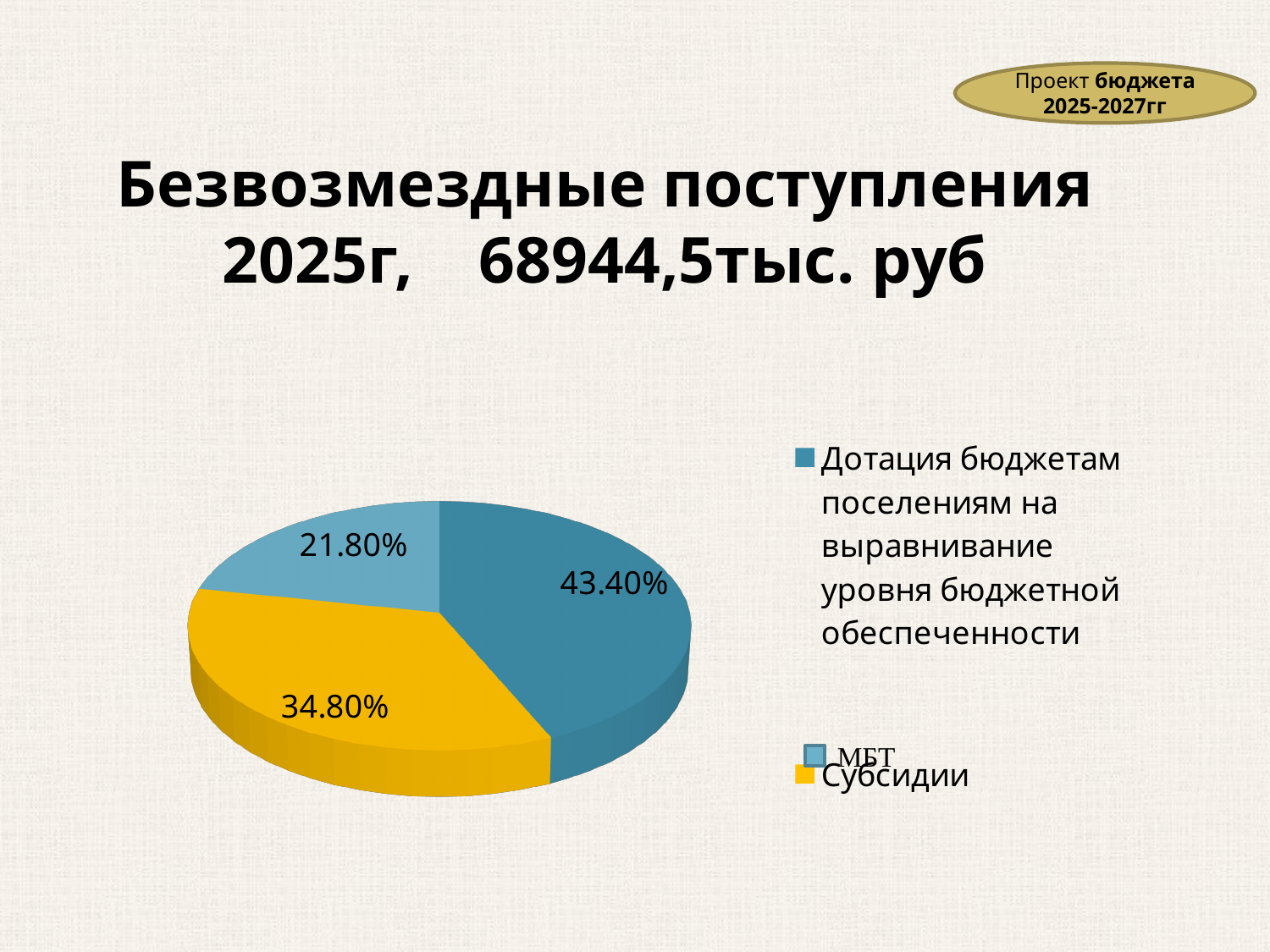
What kind of chart is shown on the slide? pie chart What colour is the slice for Субсидии? yellow What total amount in thousand rubles is stated in the slide title for 2025? 68944,5тыс. руб Which category has the smallest slice of the pie? МБТ What share of the pie does the slice for Дотация бюджетам поселениям на выравнивание уровня бюджетной обеспеченности represent? 43.40% Which category has the largest slice of the pie? Дотация бюджетам поселениям на выравнивание уровня бюджетной обеспеченности How many entries does the legend list? 3 What share of the pie does the slice for МБТ represent? 21.80% Which is larger, the slice for Субсидии or the slice for МБТ? Субсидии How many slices does the pie chart have? 3 What is the difference in percentage points between the Субсидии slice and the МБТ slice? 13.00% What share of the pie does the slice for Субсидии represent? 34.80%